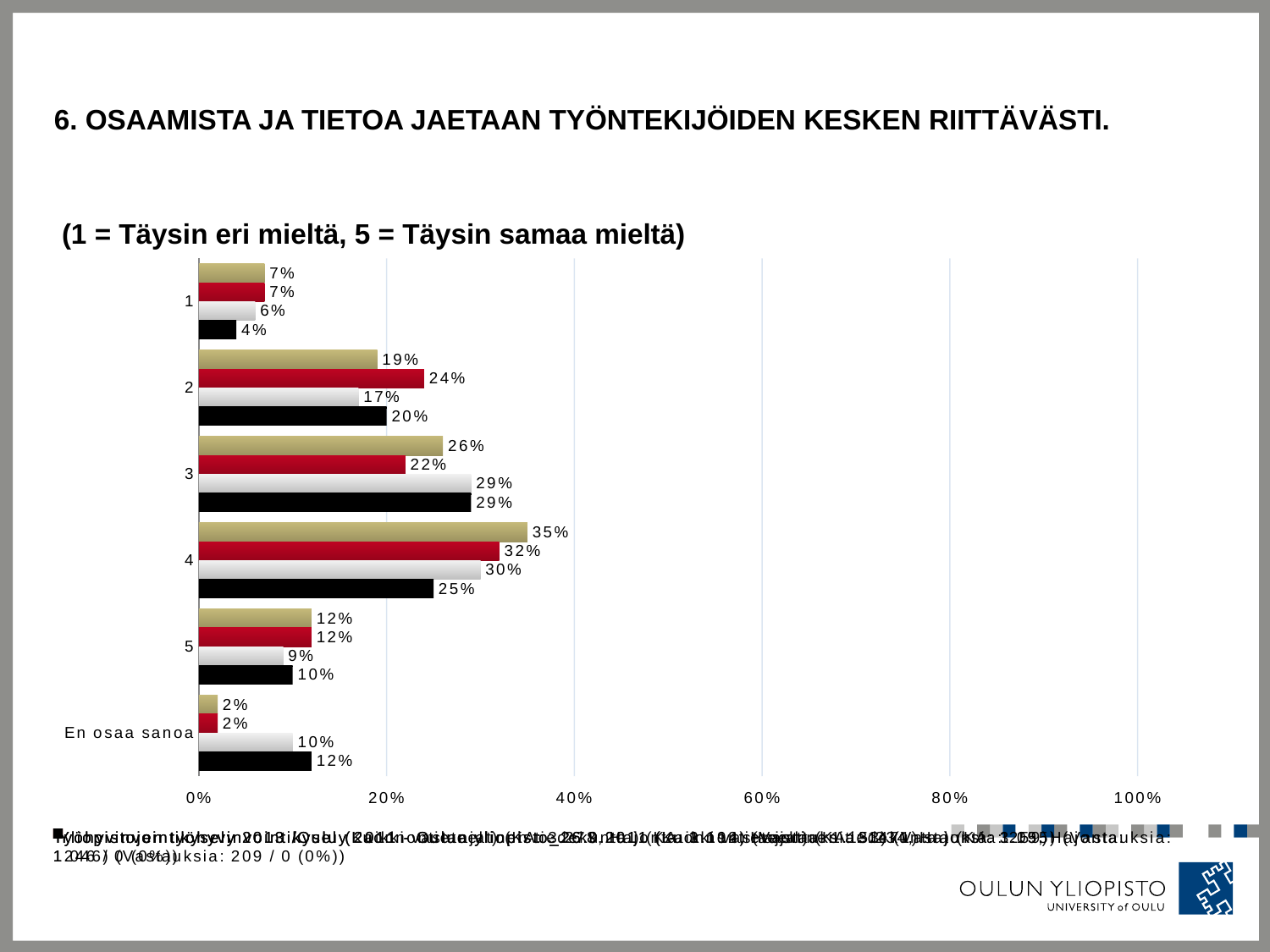
How many categories are shown on the vertical axis of the chart? 6 What is the value of the red bar for category 2? 24% What is the value of the light gray bar for 'En osaa sanoa'? 10% Is the value of the tan bar for category 4 greater or less than 20%? greater What is the value of the black bar for category 4? 25% What is the value of the tan (top) bar for category 3? 26% For category 3, which is larger: the red bar or the light gray bar? the light gray bar What is the difference between the tan bar and the black bar for category 4? 10% What type of chart is shown on the slide? bar chart Which category has the lowest value for the black bar series? 1 Which category has the highest value for the tan (top) bar series? 4 What is the difference between the black bar and the tan bar for 'En osaa sanoa'? 10%